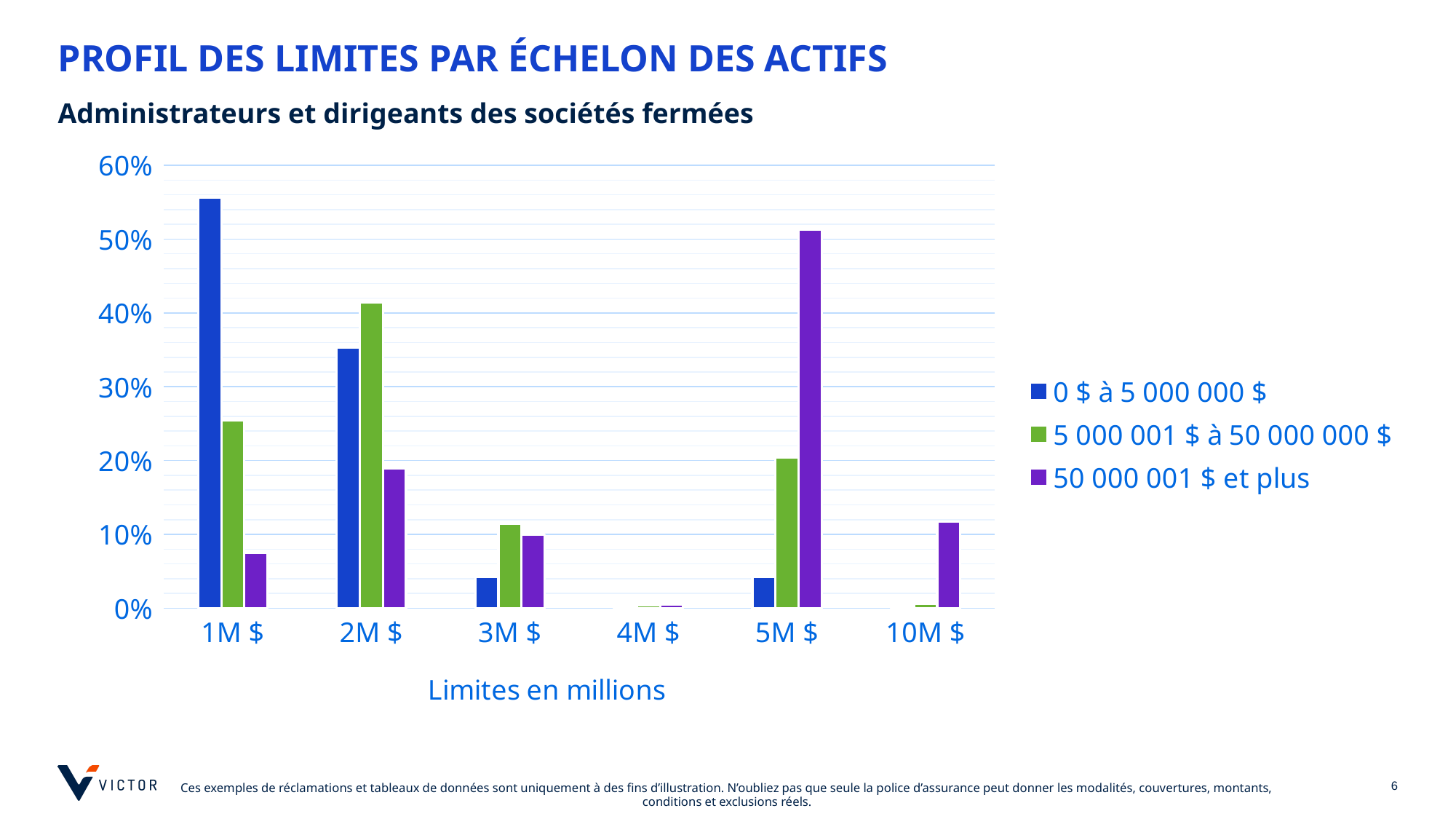
How many limit categories are shown on the x axis? 6 How many series does the legend list? 3 What kind of chart is shown on the slide? bar chart What is the x-axis title of the chart? Limites en millions For which limit is the value of the '0 $ à 5 000 000 $' series highest? 1M $ For which limit is the value of the '50 000 001 $ et plus' series highest? 5M $ For which limit is the value of the '5 000 001 $ à 50 000 000 $' series highest? 2M $ At 10M $, which series has the larger value: '5 000 001 $ à 50 000 000 $' or '50 000 001 $ et plus'? 50 000 001 $ et plus Is the value for '5 000 001 $ à 50 000 000 $' at 2M $ greater or less than 40%? greater Is the value for '0 $ à 5 000 000 $' at 1M $ greater or less than 50%? greater Is the value for '50 000 001 $ et plus' at 5M $ greater or less than 50%? greater At 2M $, which series has the larger value: '0 $ à 5 000 000 $' or '5 000 001 $ à 50 000 000 $'? 5 000 001 $ à 50 000 000 $